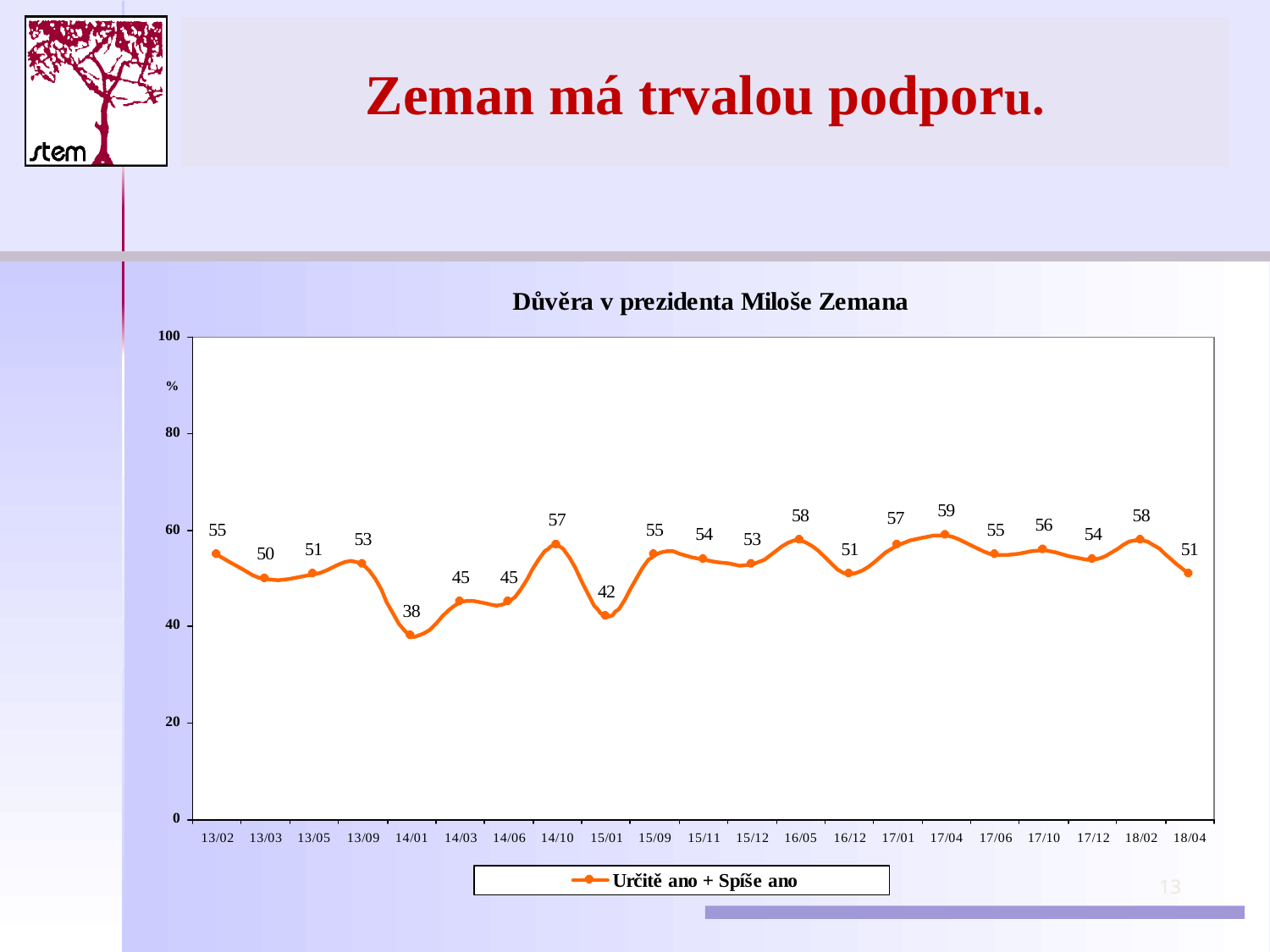
Is the value for 14/03 greater or less than 60? less How many series does the legend list? 1 What is the title of the chart? Důvěra v prezidenta Miloše Zemana Which is larger, the value for 16/05 or the value for 16/12? 16/05 Which date has the highest value? 17/04 Which date has the lowest value? 14/01 What is the value for 14/01? 38 What is the difference between the values for 14/10 and 15/01? 15 What is the value for 18/04? 51 How many data points are plotted on the chart? 21 What is the value for 17/04? 59 What kind of chart is shown? line chart